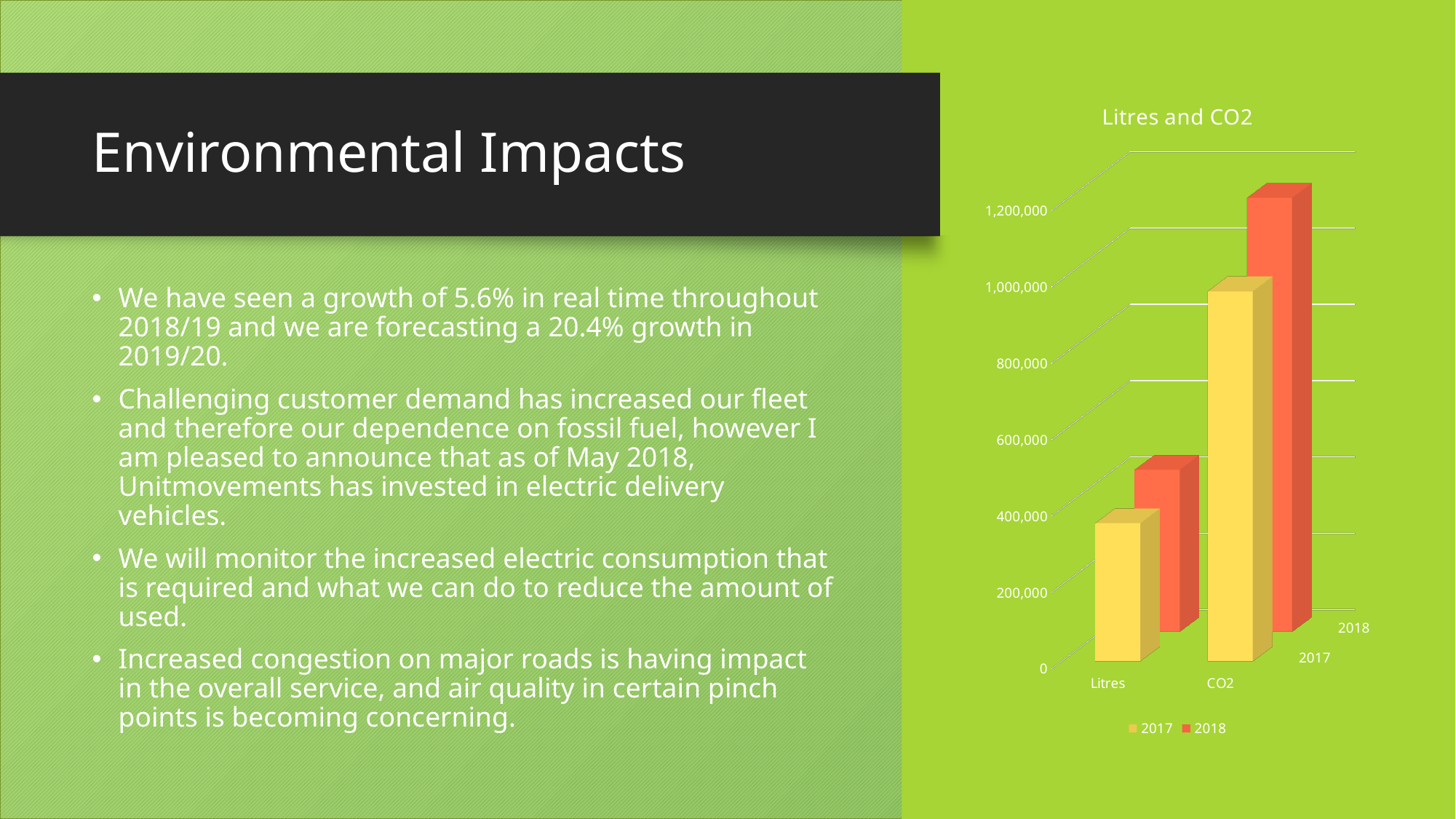
Which series are listed in the chart's legend? 2017 and 2018 How many series does the chart's legend list? 2 How many categories are shown on the x axis of the chart? 2 Is the 2017 value for CO2 greater or less than 600,000? greater For CO2, which year has the larger value, 2017 or 2018? 2018 Which category has the highest bar in the chart? CO2 Which bar is the lowest in the chart? Litres in 2017 Is the 2018 value for CO2 greater or less than 800,000? greater What is the title of the chart? Litres and CO2 For Litres, which year has the larger value, 2017 or 2018? 2018 Is the 2017 value for Litres greater or less than 600,000? less What kind of chart is shown on the slide? Bar chart